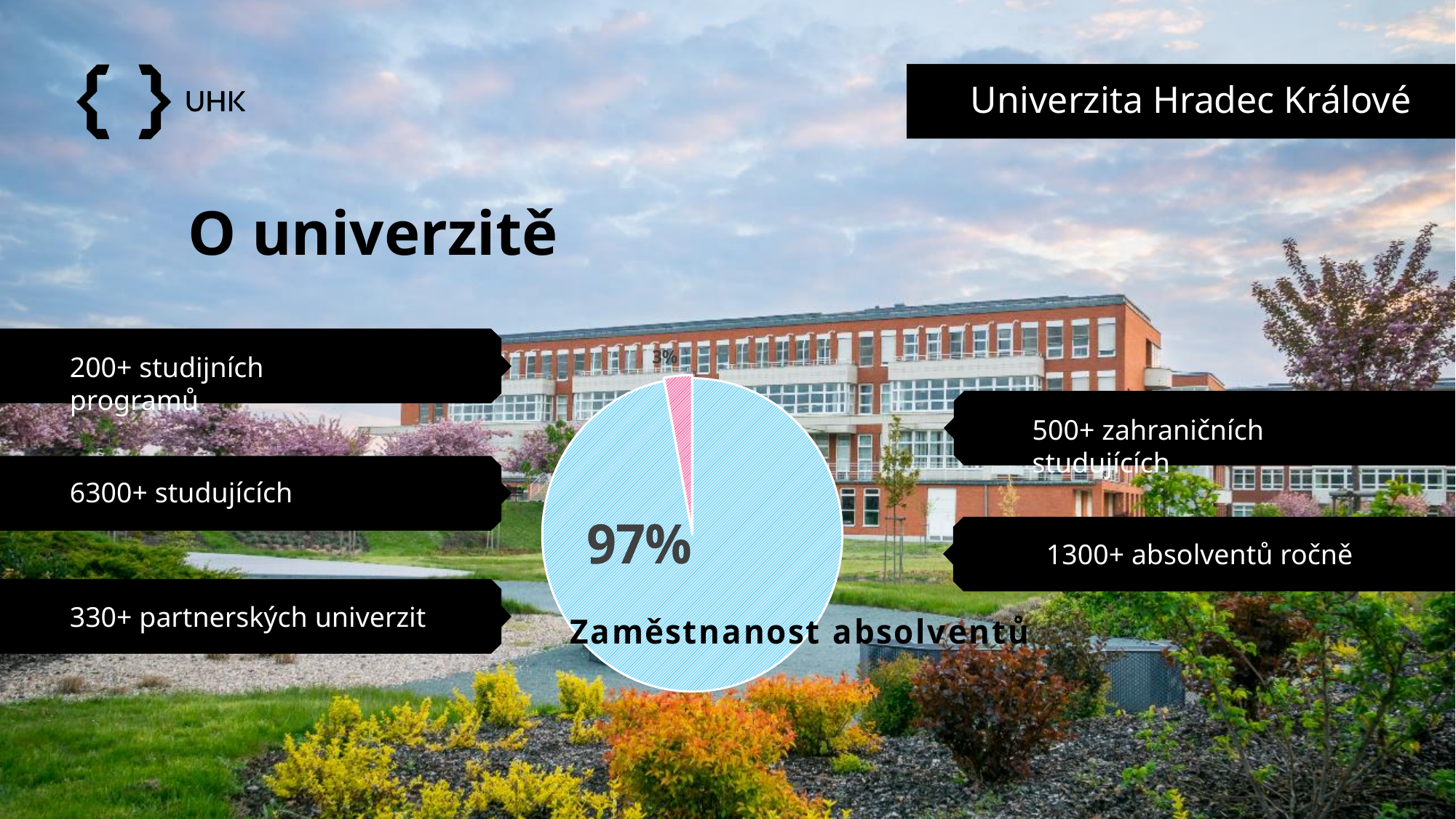
What is the title of the pie chart? Zaměstnanost absolventů What value is shown for the large blue slice of the pie chart? 97% Which slice of the pie chart is larger, the blue one or the pink one? the blue one By how many percentage points does the blue slice exceed the pink slice? 94 What value is shown for the small pink slice of the pie chart? 3% What colour is the slice labelled 3%? pink What kind of chart is shown on the slide? pie chart What is the value of the smallest slice in the pie chart? 3% How many slices does the pie chart have? 2 What is the value of the largest slice in the pie chart? 97%